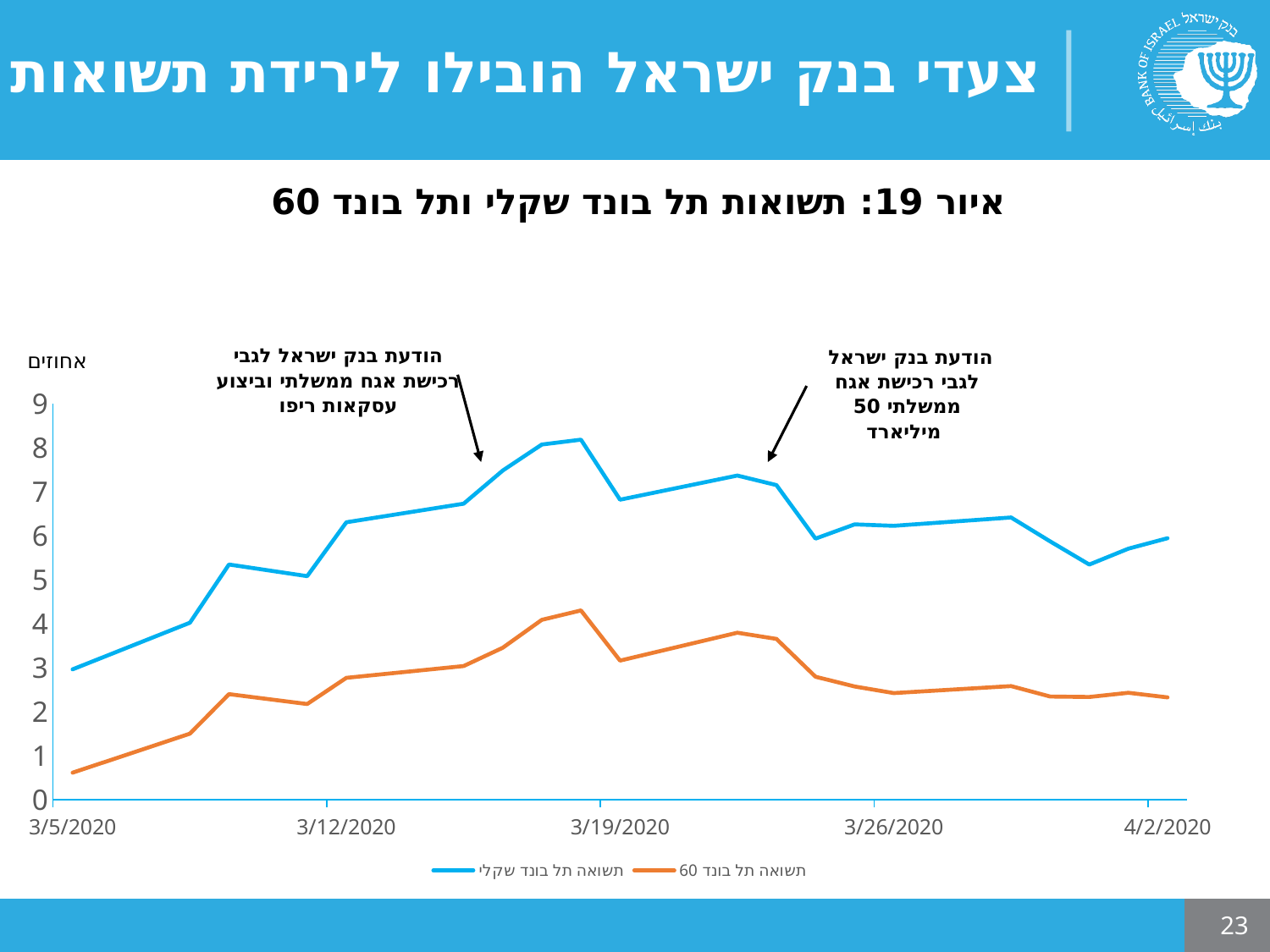
Is the value of תשואה תל בונד 60 on 3/12/2020 greater or less than 2? greater How many series does the chart legend list? 2 Does the value of תשואה תל בונד שקלי rise or fall between 3/5/2020 and 3/12/2020? rise Is the value of תשואה תל בונד שקלי on 4/2/2020 greater or less than 5? greater What unit label is shown at the top of the y axis? אחוזים Which series has the higher value on 3/19/2020, תשואה תל בונד שקלי or תשואה תל בונד 60? תשואה תל בונד שקלי Is the value of תשואה תל בונד 60 on 3/5/2020 greater or less than 1? less How many date labels are shown on the x axis? 5 What is the title of the chart? איור 19: תשואות תל בונד שקלי ותל בונד 60 What type of chart is shown on the slide? line chart